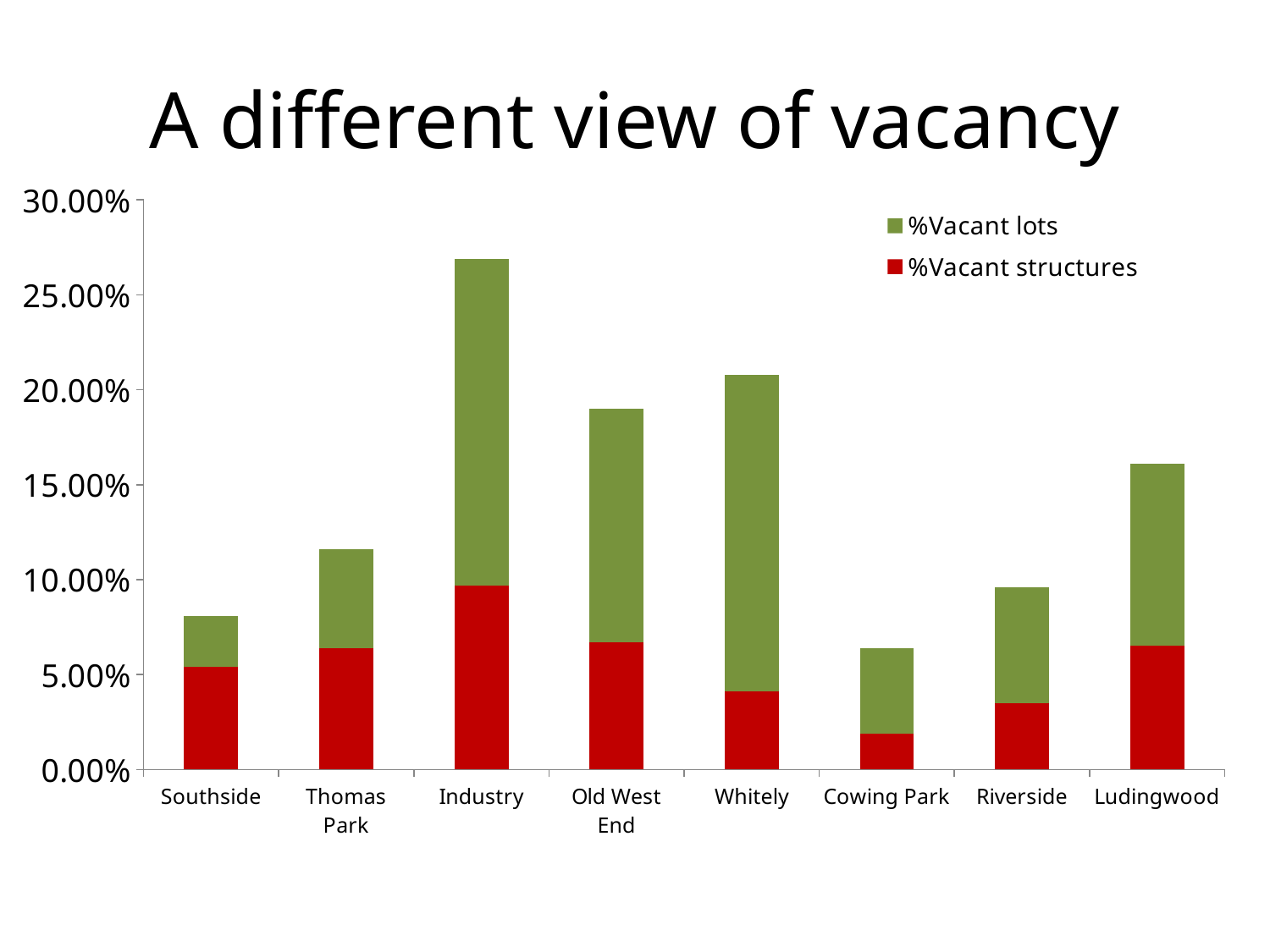
Is the %Vacant structures value for Cowing Park greater or less than 5.00%? less Which neighborhood has the tallest stacked bar (highest total vacancy)? Industry Which neighborhood has the largest %Vacant structures segment? Industry How many neighborhoods are shown on the x axis? 8 Is the total stacked bar for Industry greater or less than 25.00%? greater How many series does the legend list? 2 Which neighborhood has the shortest stacked bar (lowest total vacancy)? Cowing Park Is the total stacked bar for Southside greater or less than 10.00%? less Which has the taller stacked bar, Whitely or Ludingwood? Whitely What colour represents %Vacant lots in the chart? Green What kind of chart is shown on the slide? Stacked bar chart What is the title of the slide? A different view of vacancy